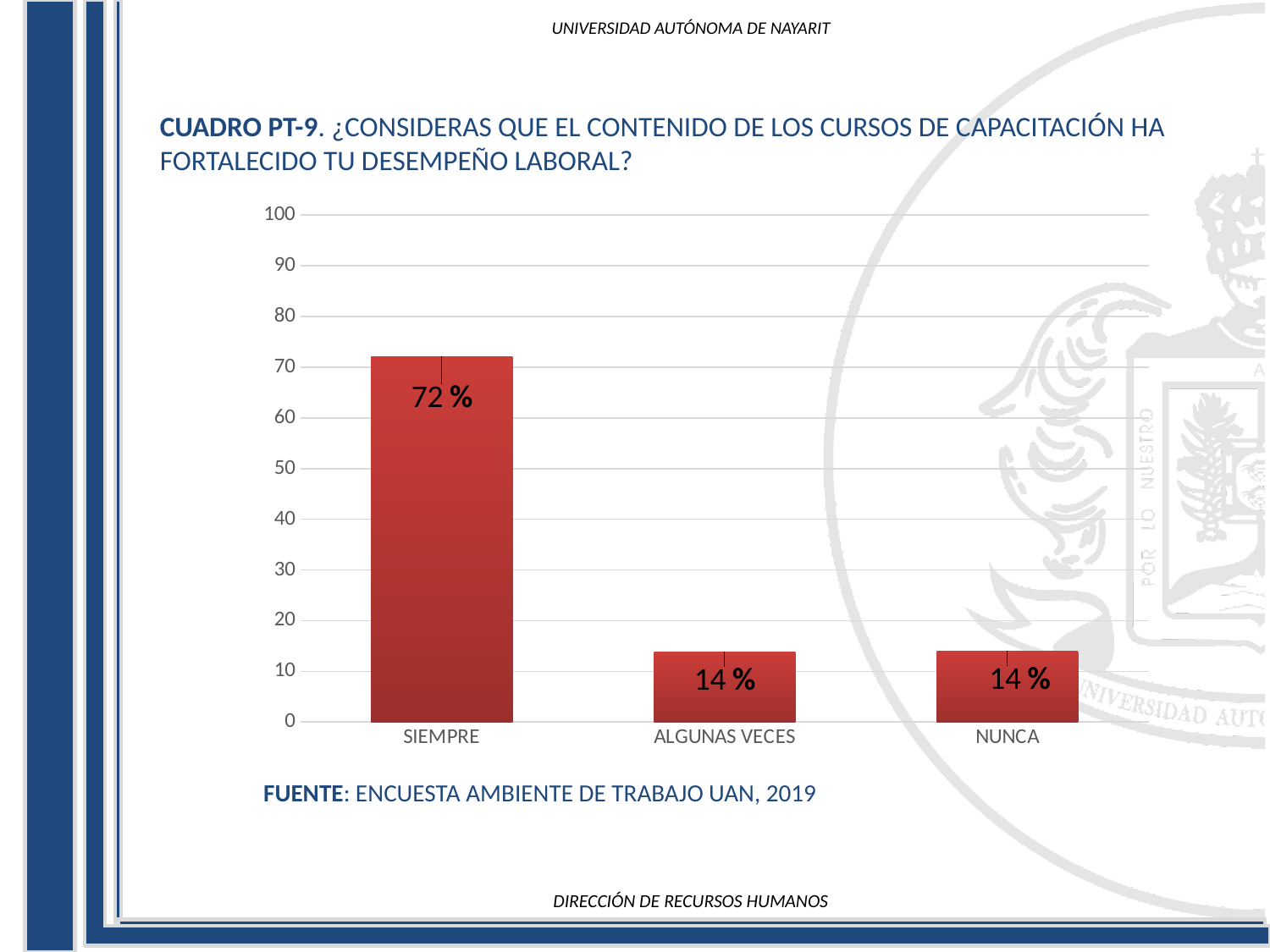
Which is larger, the value for SIEMPRE or the value for NUNCA? SIEMPRE Is the value for NUNCA greater or less than 20? less Which category has the highest value? SIEMPRE What is the difference between the values for SIEMPRE and ALGUNAS VECES? 58 % How many categories are shown on the x axis? 3 What source is cited below the chart? ENCUESTA AMBIENTE DE TRABAJO UAN, 2019 What is the value for ALGUNAS VECES? 14 % Is the value for SIEMPRE greater or less than 70? greater What is the highest value shown on the y axis? 100 What kind of chart is shown on the slide? bar chart What is the value for SIEMPRE? 72 % What is the value for NUNCA? 14 %